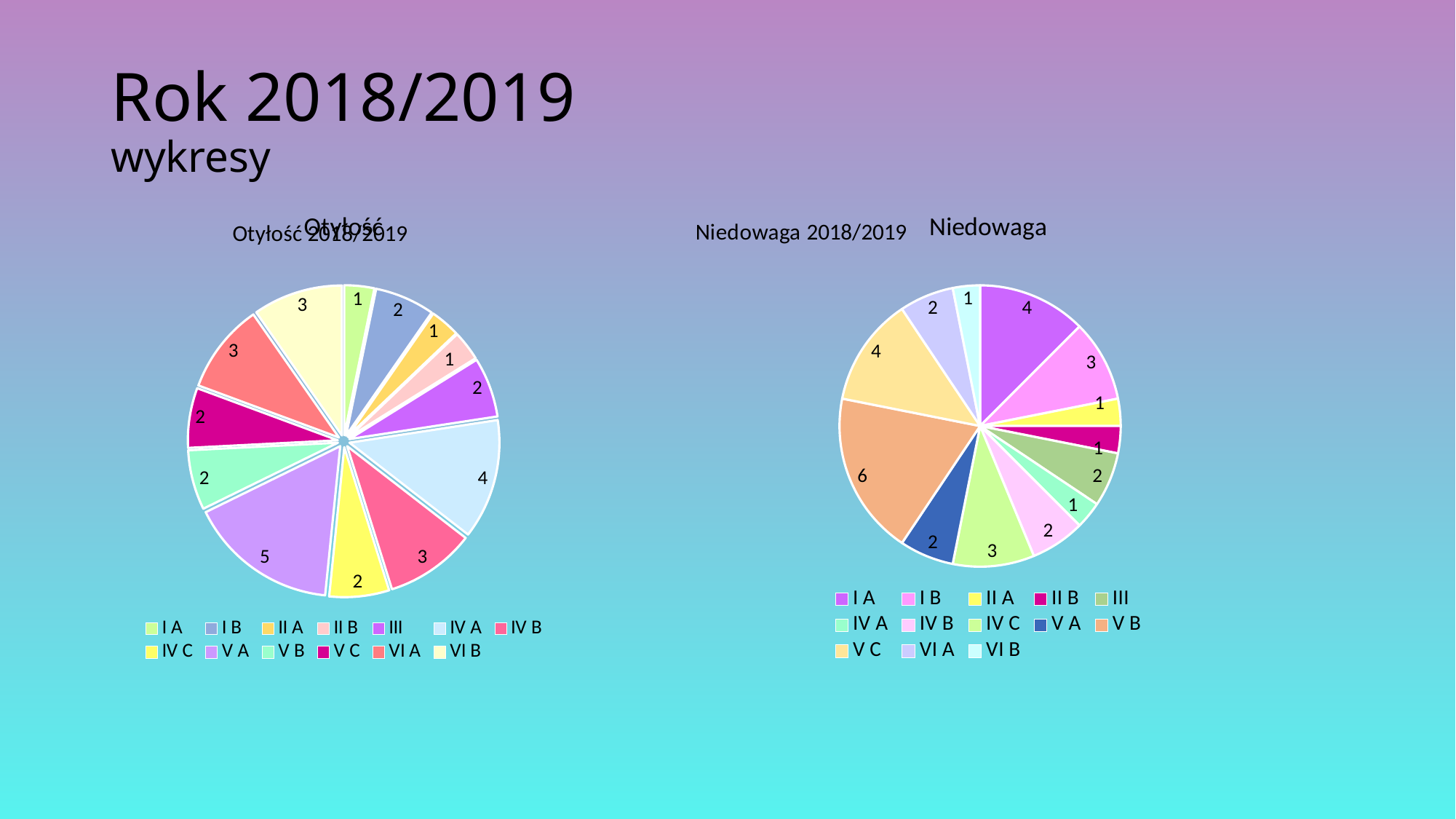
In the Otyłość 2018/2019 pie chart, what is the difference between the values for V A and IV B? 2 How many categories does the legend of the Otyłość 2018/2019 pie chart list? 13 In the Otyłość 2018/2019 pie chart, what is the value for V A? 5 What type of chart is the Niedowaga 2018/2019 chart? Pie chart In the Otyłość 2018/2019 pie chart, which is larger, the value for I B or the value for VI A? VI A In the Niedowaga 2018/2019 pie chart, which category has the largest slice? V B In the Otyłość 2018/2019 pie chart, which category has the largest slice? V A In the Niedowaga 2018/2019 pie chart, what is the value for V B? 6 In the Otyłość 2018/2019 pie chart, what is the value for IV A? 4 In the Niedowaga 2018/2019 pie chart, what is the difference between the values for V B and I B? 3 In the Niedowaga 2018/2019 pie chart, what is the value for I A? 4 In the Niedowaga 2018/2019 pie chart, which is larger, the value for IV C or the value for VI B? IV C